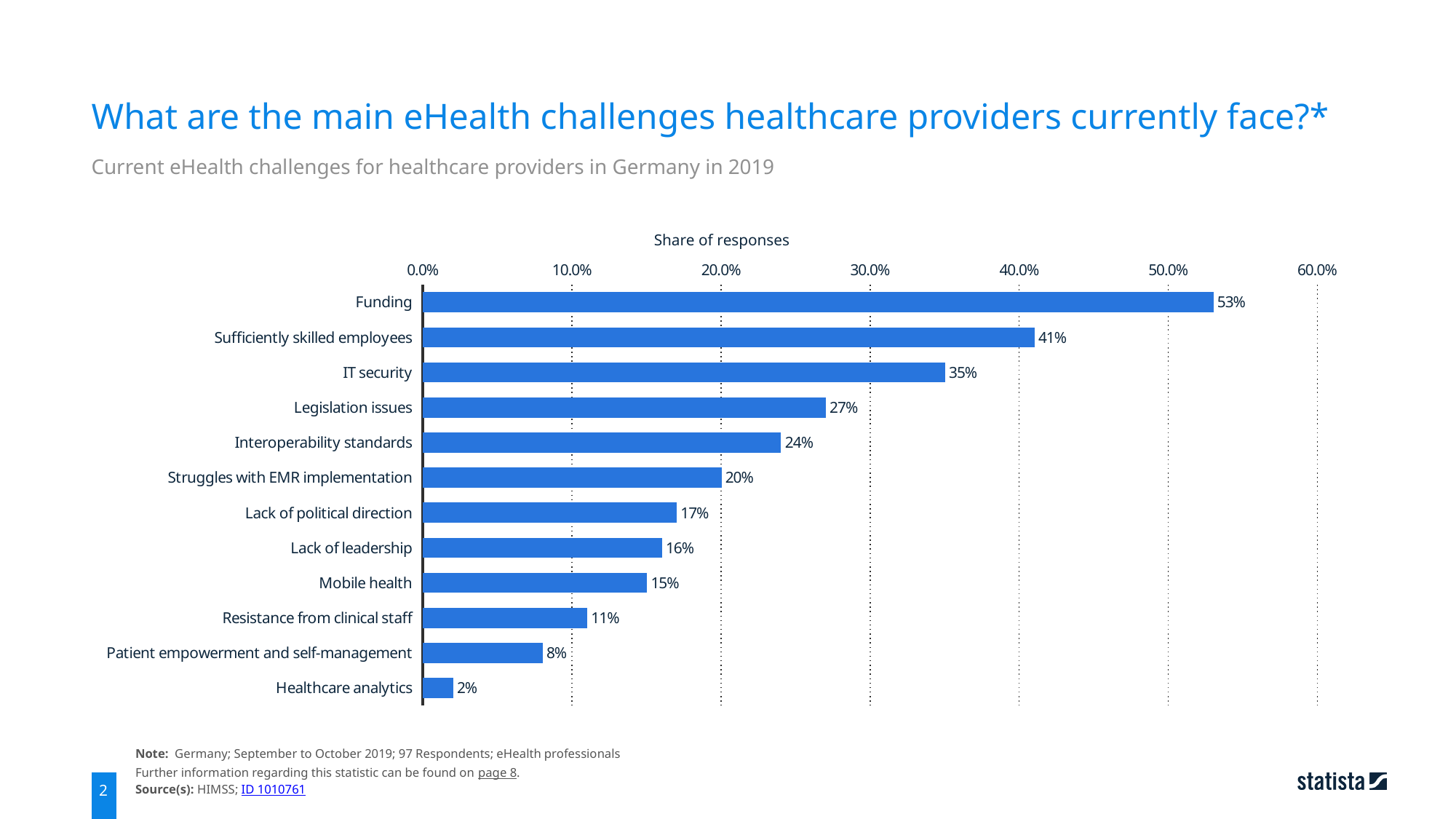
What is the label of the value axis? Share of responses Is the value for Struggles with EMR implementation greater or less than 30.0%? less Which challenge has the lowest share of responses? Healthcare analytics What is the share of responses for Funding? 53% What kind of chart is shown on the slide? Bar chart How many challenges are shown in the chart? 12 What is the share of responses for Mobile health? 15% Which challenge has the highest share of responses? Funding What is the difference in share of responses between Patient empowerment and self-management and Healthcare analytics? 6% What is the difference in share of responses between Funding and Sufficiently skilled employees? 12% What is the share of responses for IT security? 35% Which has a larger share of responses, Legislation issues or Interoperability standards? Legislation issues